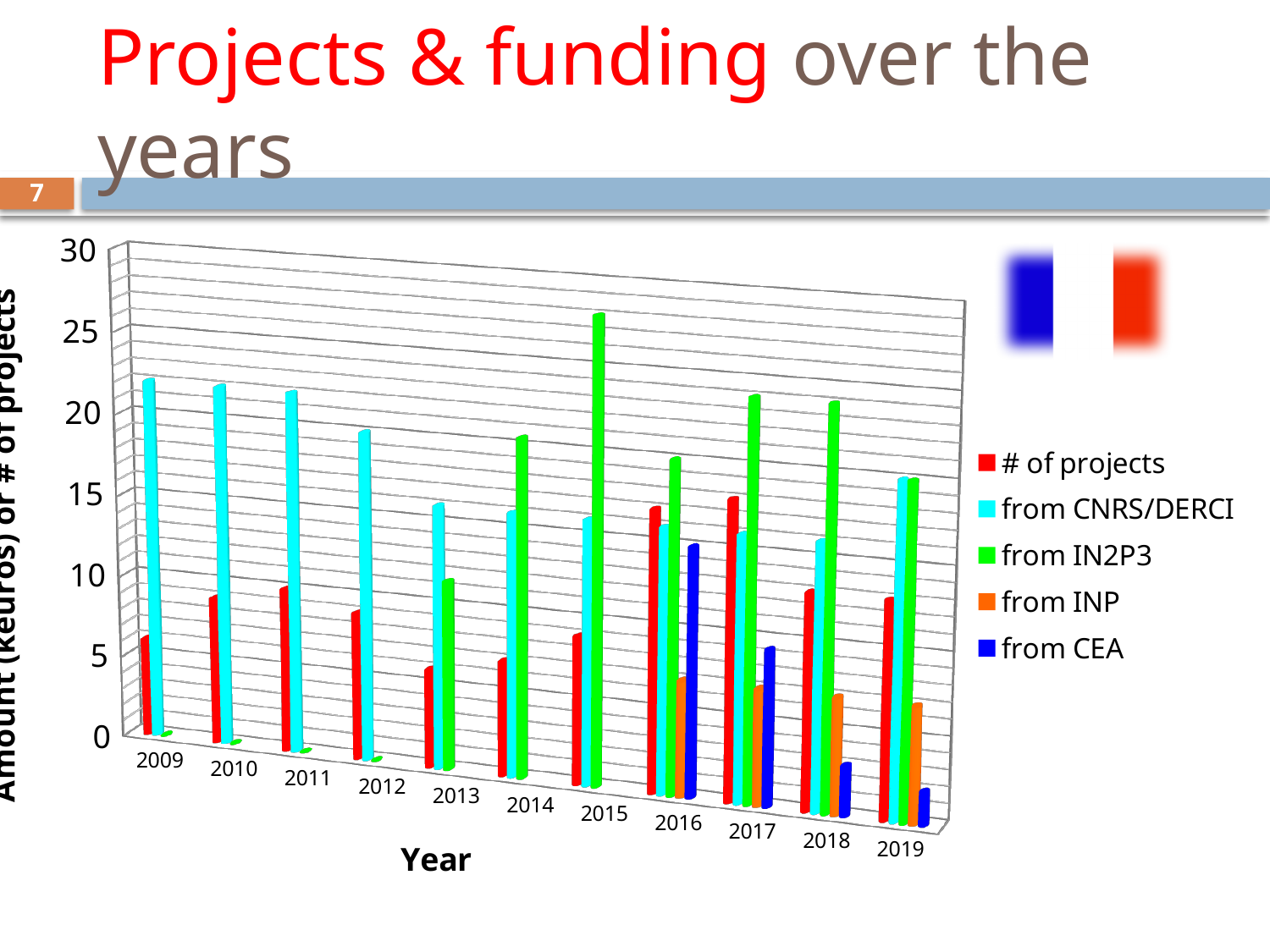
What is the title of the x axis? Year Which is larger in 2009: the 'from CNRS/DERCI' bar or the '# of projects' bar? from CNRS/DERCI Is the value for '# of projects' in 2013 greater or less than 10? less Which series is shown in green in the legend? from IN2P3 How many years are shown along the x axis? 11 Which series has the highest bar in 2009? from CNRS/DERCI Is the value for 'from IN2P3' in 2015 greater or less than 20? greater Is the value for 'from INP' in 2016 greater or less than 10? less How many series does the legend list? 5 In which year is the 'from IN2P3' bar the highest? 2015 What kind of chart is shown on the slide? bar chart